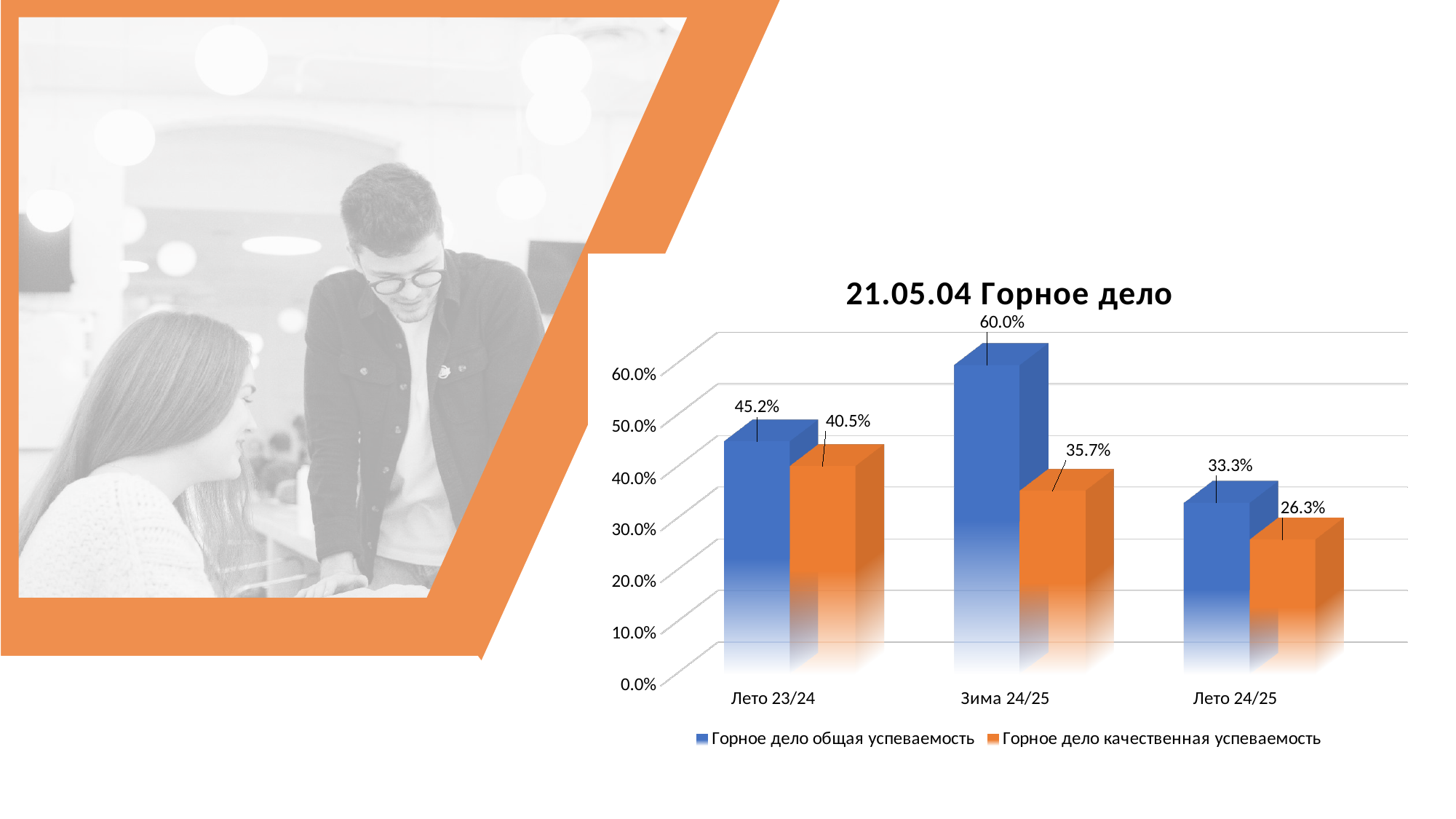
Is the value of Горное дело общая успеваемость for Лето 24/25 greater or less than 40.0%? less What is the value of Горное дело общая успеваемость for Зима 24/25? 60.0% What is the title of the chart? 21.05.04 Горное дело How many periods are shown on the x axis? 3 What is the difference between Горное дело общая успеваемость and Горное дело качественная успеваемость for Зима 24/25? 24.3% How many series does the legend list? 2 Which is larger for Лето 23/24: Горное дело общая успеваемость or Горное дело качественная успеваемость? Горное дело общая успеваемость What is the value of Горное дело качественная успеваемость for Лето 24/25? 26.3% What is the value of Горное дело качественная успеваемость for Лето 23/24? 40.5% Which period has the lowest value for Горное дело качественная успеваемость? Лето 24/25 Which period has the highest value for Горное дело общая успеваемость? Зима 24/25 What kind of chart is shown on the slide? Bar chart